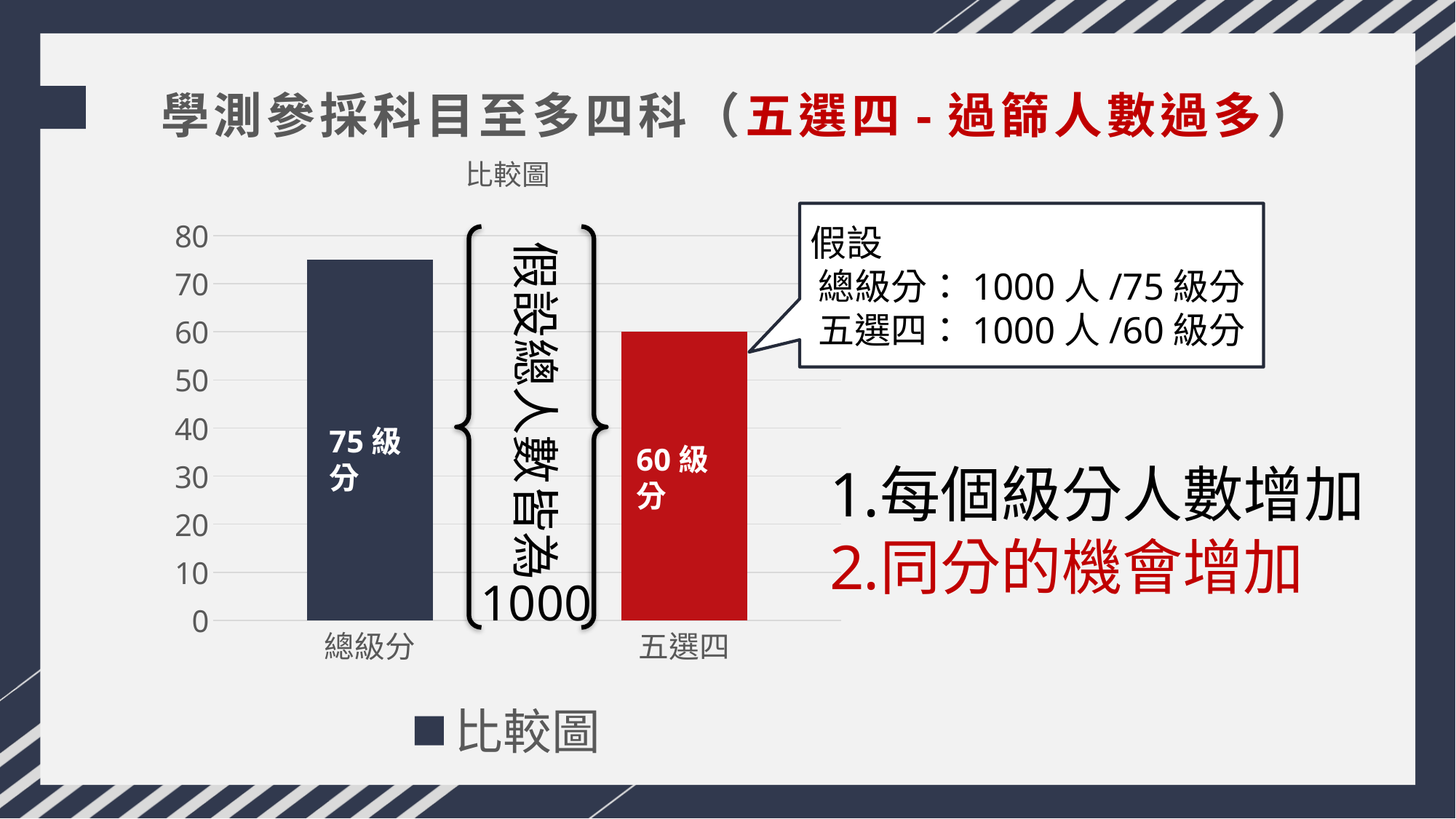
Which category has the lower bar? 五選四 What is the difference between the values for 總級分 and 五選四? 15 Which category has the higher bar? 總級分 What is the value shown for 總級分? 75 級分 How many series does the legend list? 1 What is the value shown for 五選四? 60 級分 What is the title of the chart? 比較圖 Is the value for 總級分 greater or less than 70? greater How many categories are shown on the x axis? 2 Is the value for 總級分 larger or smaller than the value for 五選四? larger What kind of chart is shown? bar chart Is the value for 五選四 greater or less than 70? less